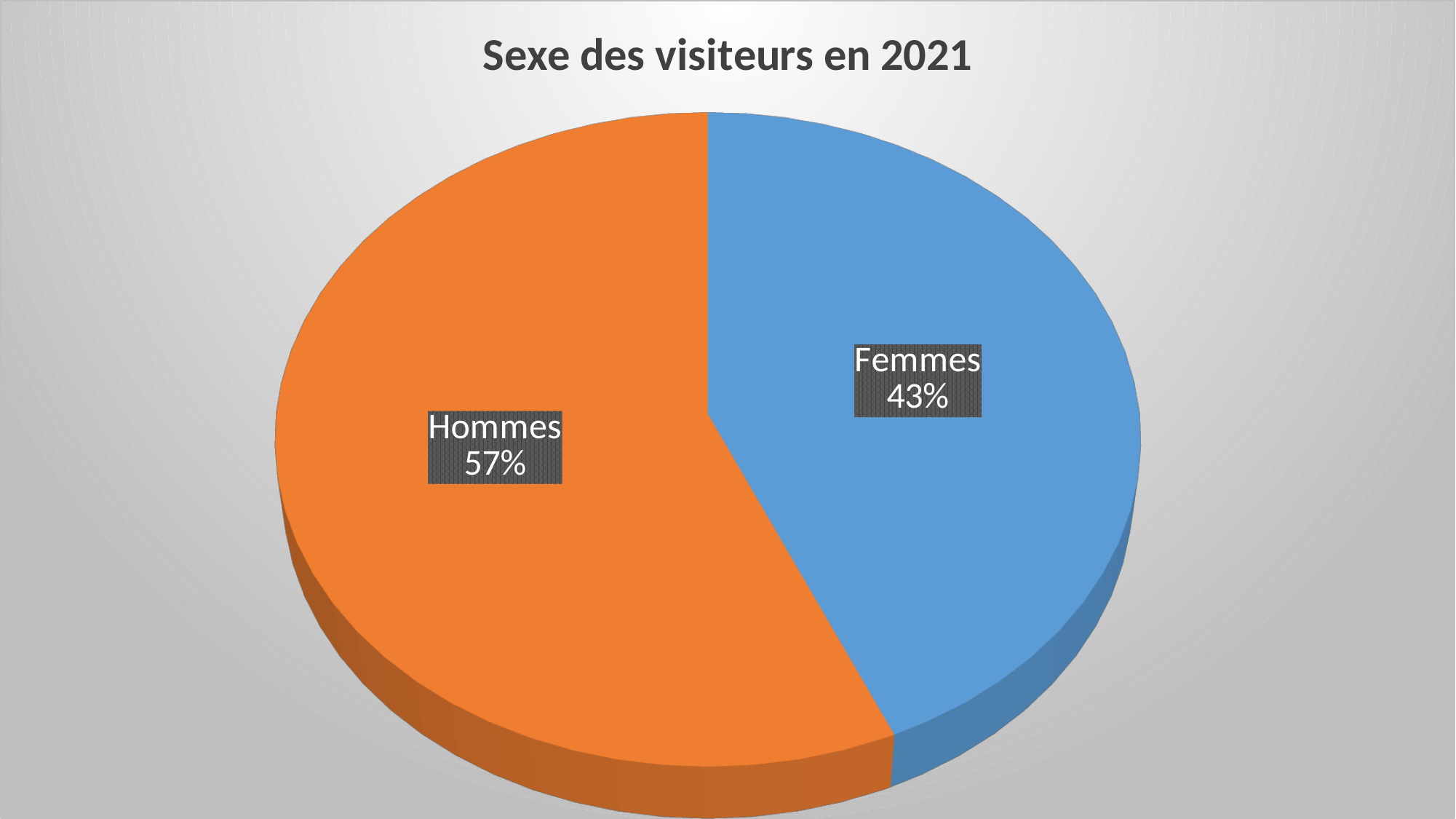
What is the title of the chart? Sexe des visiteurs en 2021 What share of visitors in 2021 were Hommes? 57% Which category has the largest slice of the pie? Hommes What is the total of the two slices shown? 100% What colour is the Femmes slice? Blue Which is larger, the share for Hommes or the share for Femmes? Hommes What is the difference in percentage points between Hommes and Femmes? 14 What share of visitors in 2021 were Femmes? 43% Which category has the smallest slice of the pie? Femmes How many categories does the pie chart show? 2 Is the share for Hommes greater or less than 50%? greater What kind of chart is shown on the slide? Pie chart